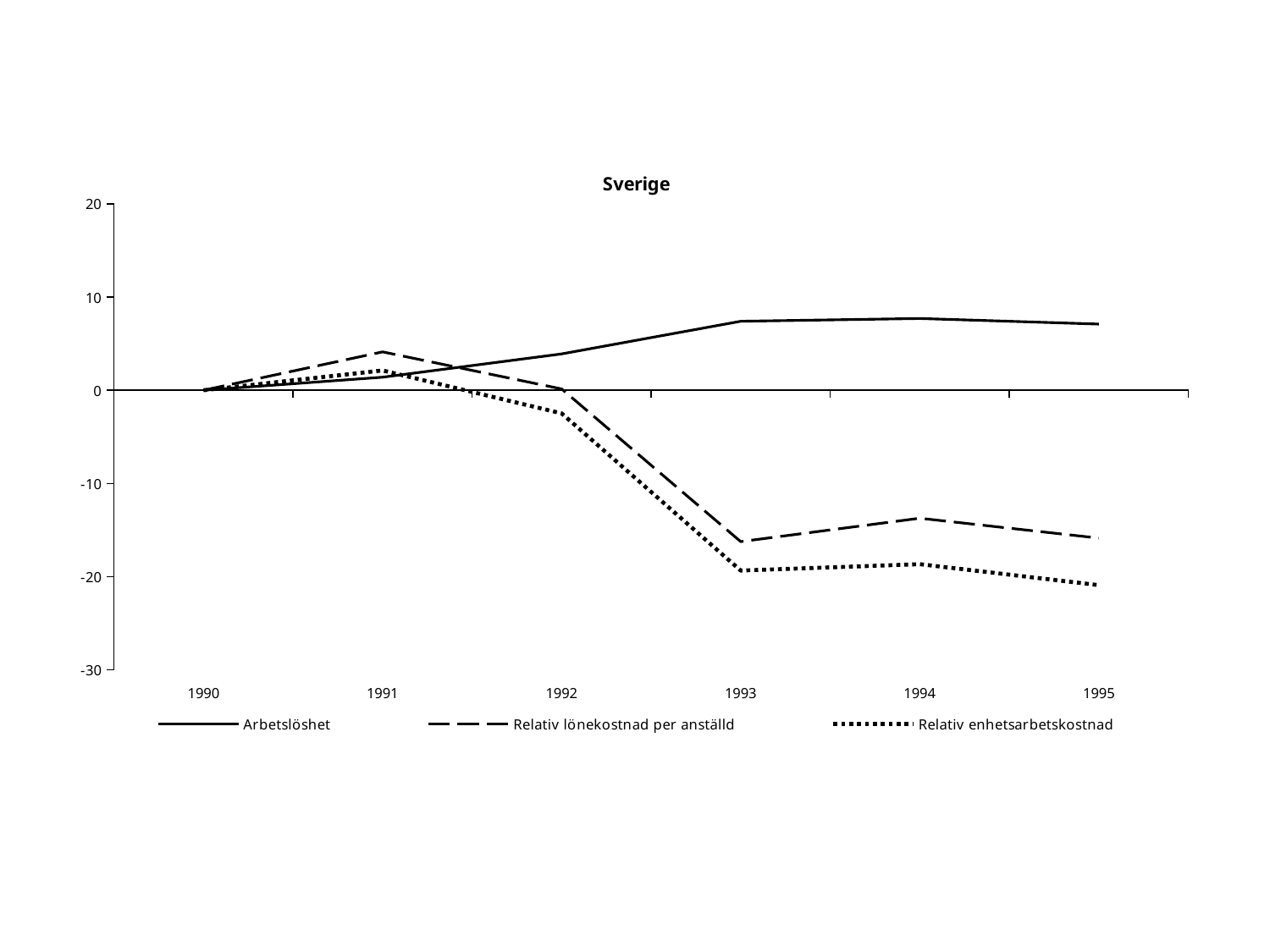
Which series has the lowest value in 1995? Relativ enhetsarbetskostnad Does Relativ enhetsarbetskostnad rise or fall from 1992 to 1993? fall What kind of chart is shown on the slide? line chart Is the value of Arbetslöshet in 1994 greater or less than 10? less How many series does the legend list? 3 How many years are shown on the x axis? 6 What is the title of the chart? Sverige Is the value of Relativ lönekostnad per anställd in 1993 greater or less than -10? less What is the value of Arbetslöshet in 1990? 0 In 1993, which is larger: Arbetslöshet or Relativ lönekostnad per anställd? Arbetslöshet Is the value of Arbetslöshet in 1993 greater or less than 0? greater Which series has the highest value in 1995? Arbetslöshet